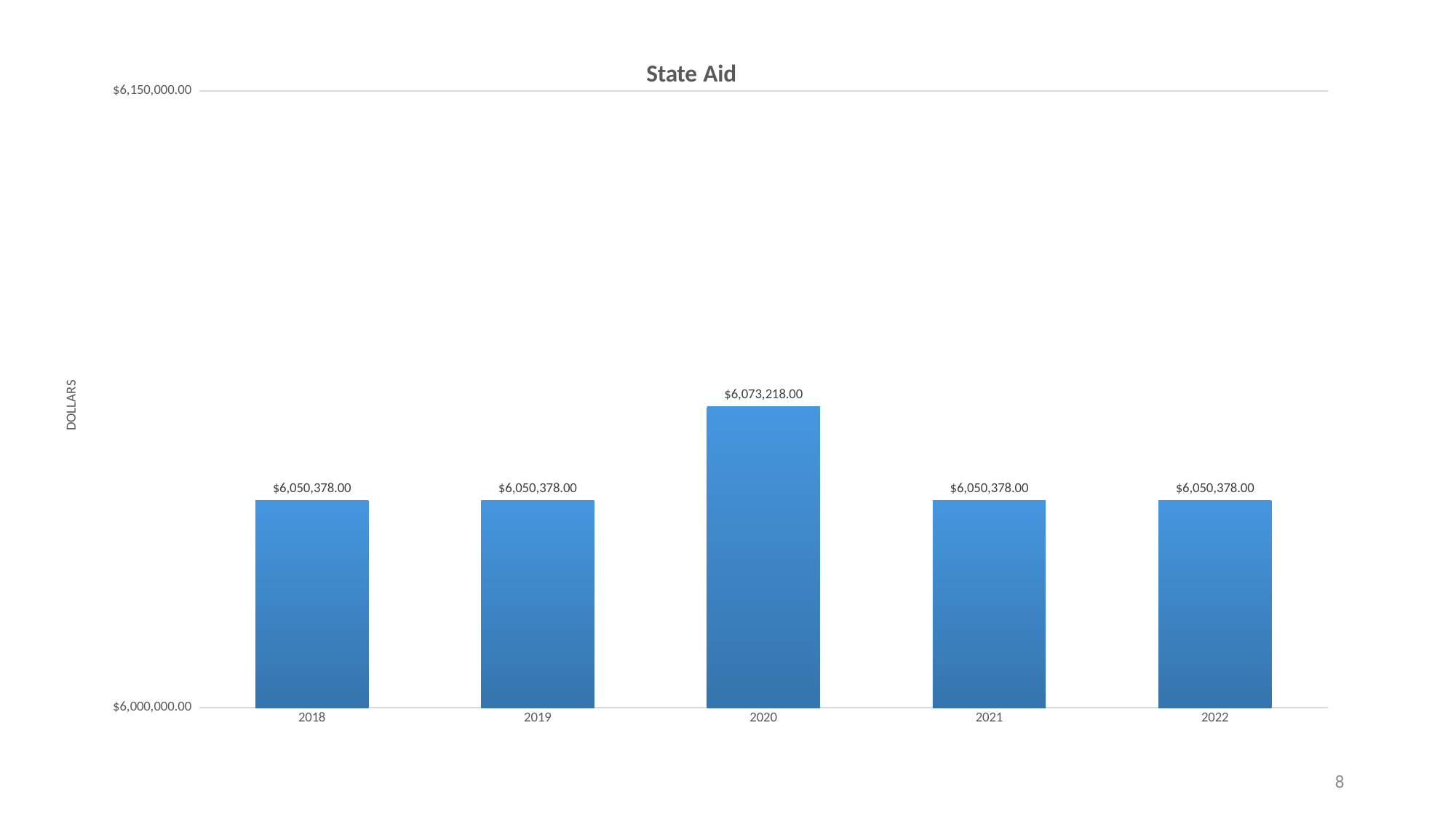
What is the title of the chart? State Aid What is the label on the vertical axis? DOLLARS Is the value for 2020 greater or less than $6,150,000.00? less What is the value for 2018? $6,050,378.00 What is the value for 2020? $6,073,218.00 How many years are shown on the x axis? 5 What is the value for 2022? $6,050,378.00 What is the difference between the 2020 value and the 2019 value? $22,840.00 Is the value for 2018 greater or less than $6,000,000.00? greater Which year has the highest State Aid value? 2020 What kind of chart is this? bar chart Which is larger, the value for 2020 or the value for 2021? 2020